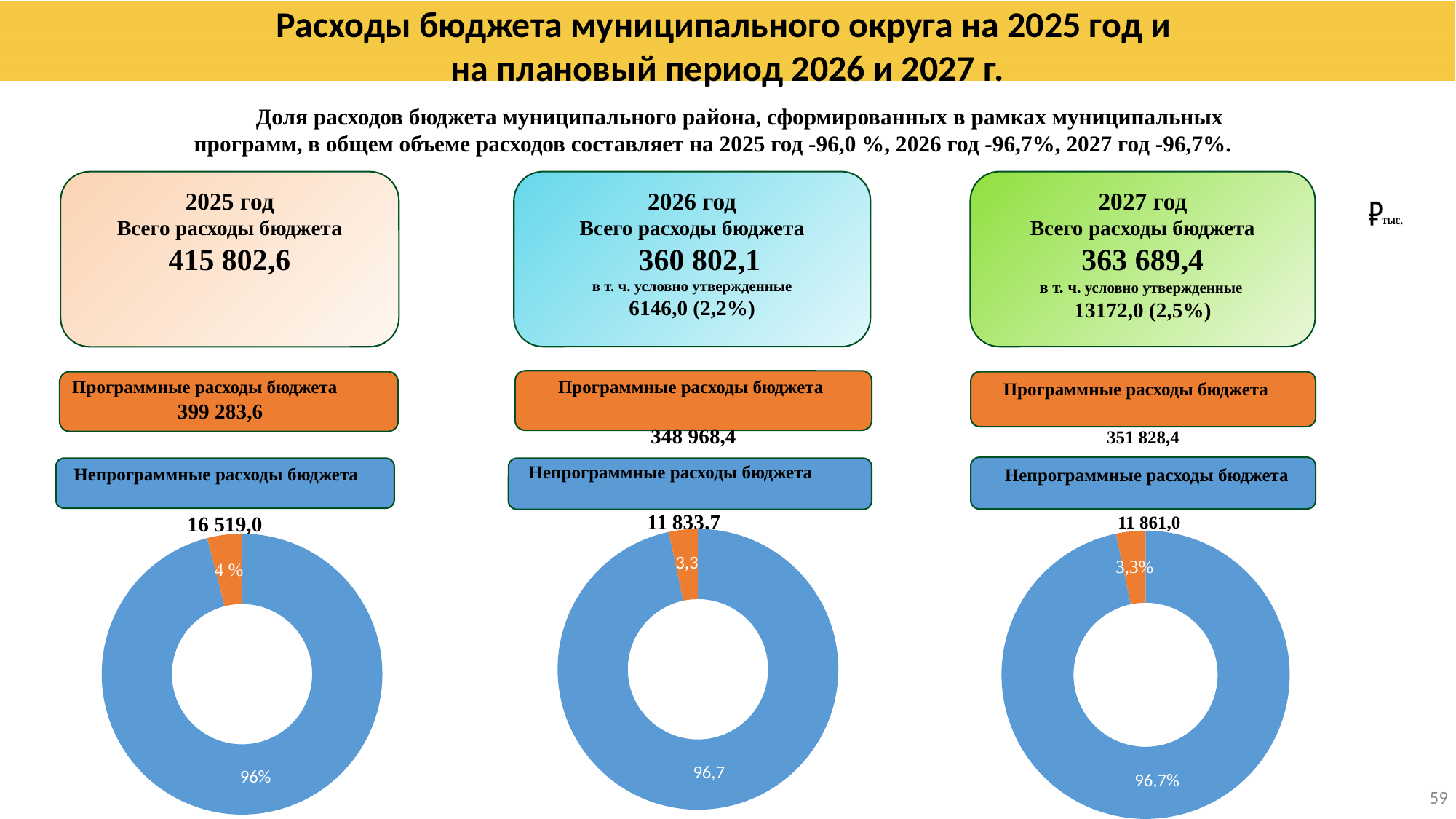
In the middle pie chart (2026 год), what value is printed on the large blue slice? 96,7 How many pie (donut) charts are shown on the slide? 3 What kind of chart is shown under the 2025 год block on the left of the slide? doughnut chart In the right pie chart (2027 год), what colour is the largest slice? blue How many slices does the left pie chart (2025 год) have? 2 In the left pie chart (2025 год), which slice is larger, the blue one or the orange one? the blue one In the right pie chart (2027 год), what percentage is printed on the small orange slice? 3,3% In the left pie chart (2025 год), what is the difference between the blue slice's percentage and the orange slice's percentage? 92% In the middle pie chart (2026 год), what value is printed on the small orange slice? 3,3 In the left pie chart (2025 год), what percentage is printed on the small orange slice? 4 % In the right pie chart (2027 год), what percentage is printed on the large blue slice? 96,7% In the left pie chart (2025 год), what percentage is printed on the large blue slice? 96%